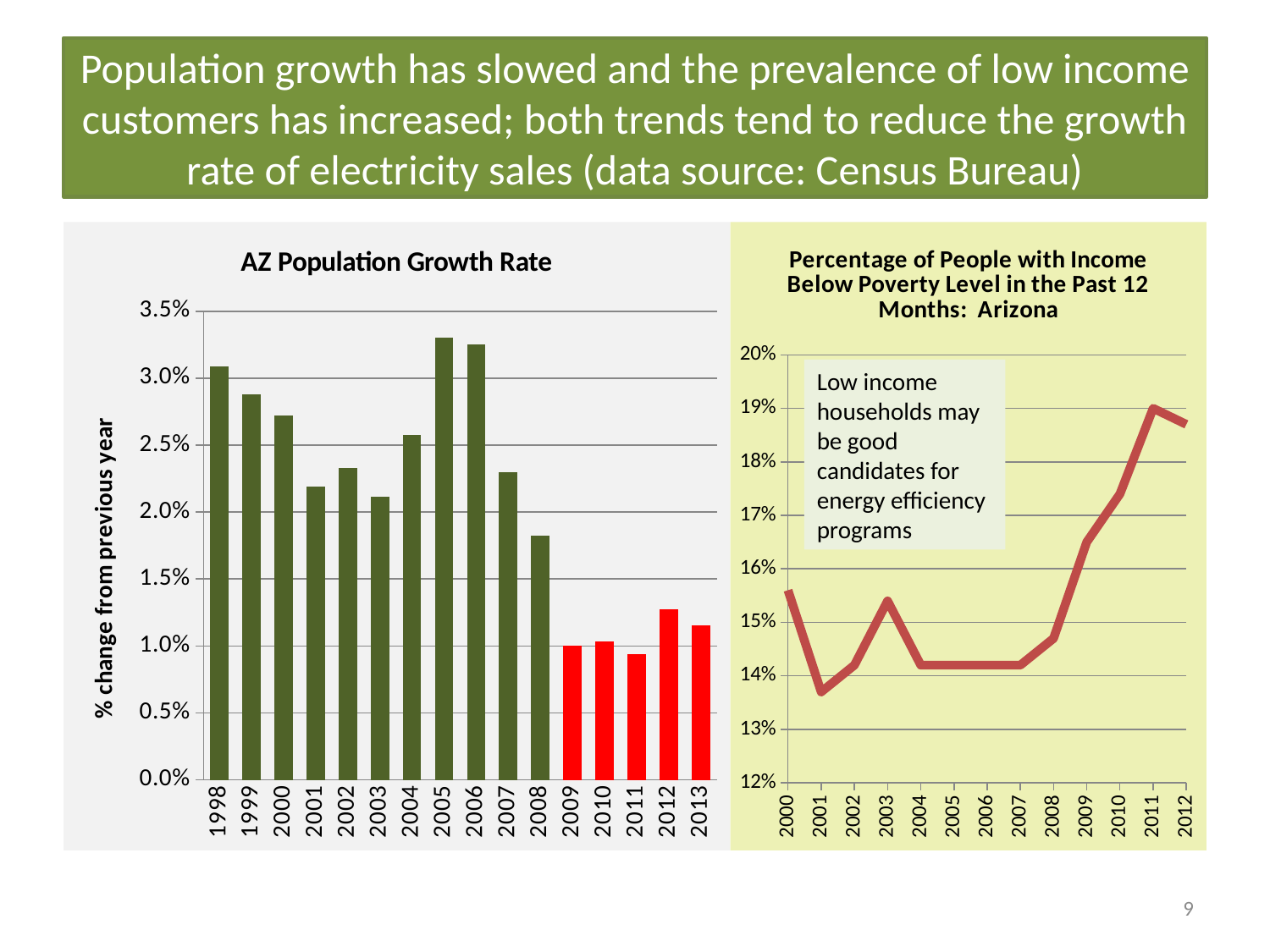
In the Percentage of People with Income Below Poverty Level chart, which year has the highest value? 2011 What kind of chart is the AZ Population Growth Rate chart? bar chart In the Percentage of People with Income Below Poverty Level chart, do the values rise or fall from 2007 to 2011? rise In the Percentage of People with Income Below Poverty Level chart, which year has the lowest value? 2001 In the AZ Population Growth Rate chart, is the value for 2012 greater or less than 1.0%? greater In the AZ Population Growth Rate chart, is the value for 2008 greater or less than 2.0%? less In the Percentage of People with Income Below Poverty Level chart, is the value for 2012 greater or less than 18%? greater How many years are shown on the x axis of the AZ Population Growth Rate chart? 16 In the AZ Population Growth Rate chart, how many bars are coloured red? 5 What is the y-axis title of the AZ Population Growth Rate chart? % change from previous year In the AZ Population Growth Rate chart, which is larger, the value for 2000 or the value for 2001? 2000